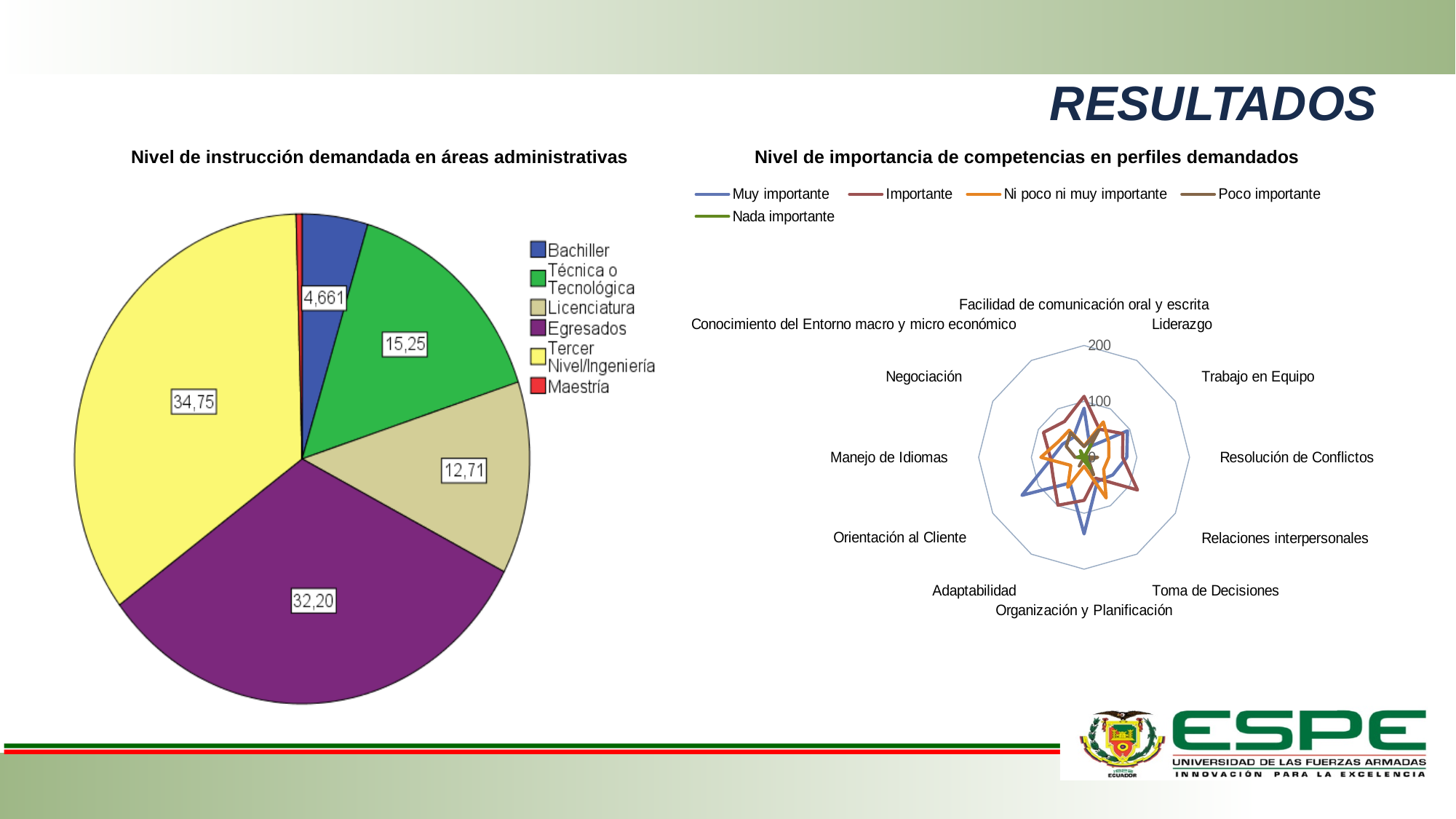
On the chart 'Nivel de instrucción demandada en áreas administrativas', how many categories does the legend list? 6 On the chart 'Nivel de instrucción demandada en áreas administrativas', what is the value for Tercer Nivel/Ingeniería? 34,75 What kind of chart is 'Nivel de instrucción demandada en áreas administrativas'? Pie chart On the chart 'Nivel de importancia de competencias en perfiles demandados', how many series does the legend list? 5 On the chart 'Nivel de instrucción demandada en áreas administrativas', which category has the smallest slice? Maestría On the chart 'Nivel de instrucción demandada en áreas administrativas', what is the value for Bachiller? 4,661 On the chart 'Nivel de instrucción demandada en áreas administrativas', which category has the largest slice? Tercer Nivel/Ingeniería On the chart 'Nivel de instrucción demandada en áreas administrativas', what is the value for Egresados? 32,20 On the chart 'Nivel de instrucción demandada en áreas administrativas', what is the value for Licenciatura? 12,71 On the chart 'Nivel de instrucción demandada en áreas administrativas', which is larger: Técnica o Tecnológica or Licenciatura? Técnica o Tecnológica On the chart 'Nivel de instrucción demandada en áreas administrativas', what is the difference between the values for Tercer Nivel/Ingeniería and Egresados? 2,55 On the chart 'Nivel de importancia de competencias en perfiles demandados', how many competencies are plotted around the chart? 12